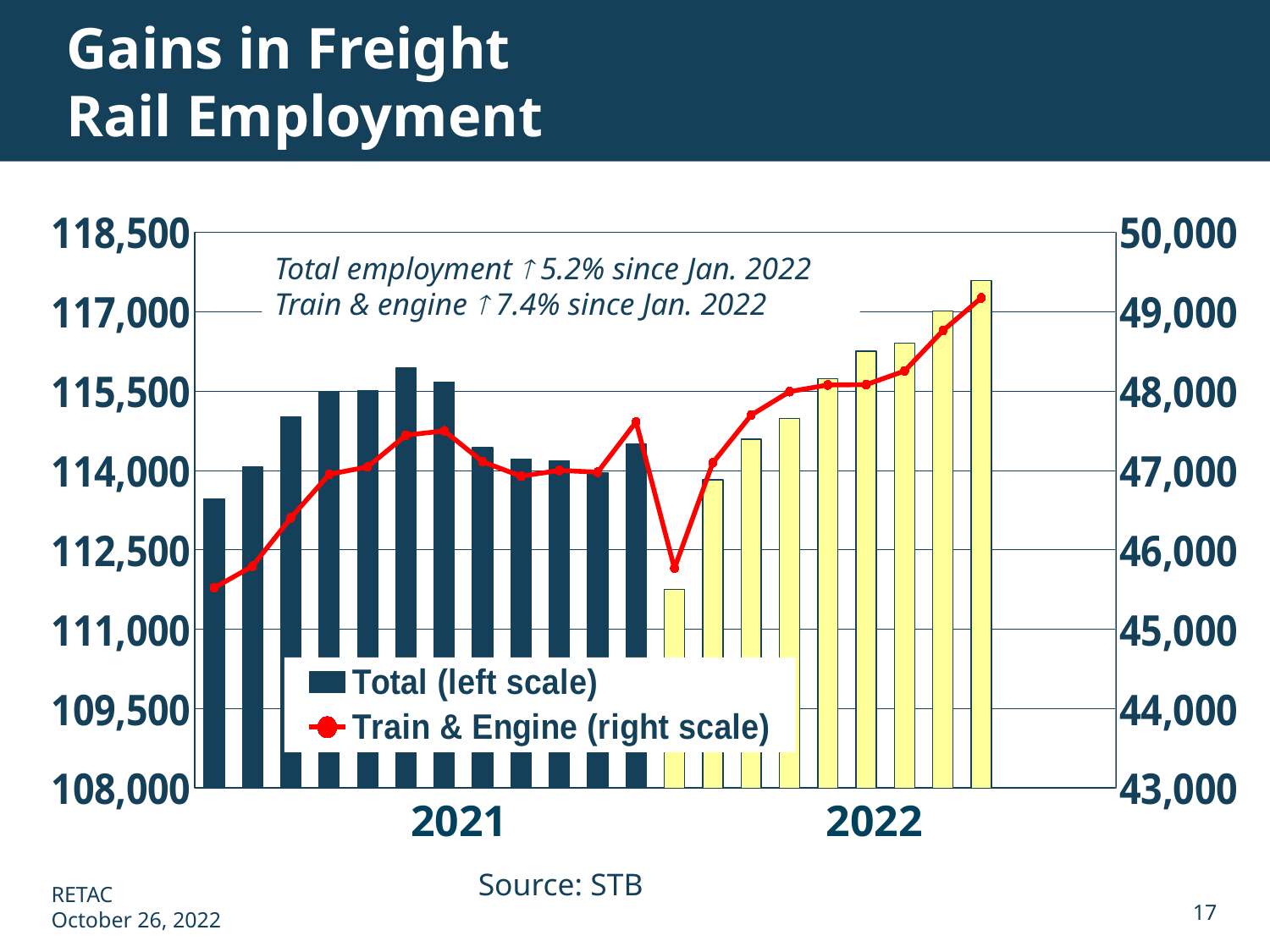
How many bars are plotted for 2022? 9 Which bar is the lowest on the chart? The first bar of 2022 How many bars are plotted for 2021? 12 Is the value of the first Total bar in 2021 greater or less than 114,000? less Is the value of the last Total bar in 2022 greater or less than 117,000? greater Is the last Train & Engine value in 2022 greater or less than 49,000? greater Which series is plotted on the right scale? Train & Engine What kind of chart is shown on the slide? A combination bar and line chart By what percentage has total employment risen since Jan. 2022, according to the annotation? 5.2% Do the Total bars rise or fall across the 2022 months? Rise How many series does the legend list? 2 By what percentage has train & engine employment risen since Jan. 2022, according to the annotation? 7.4%